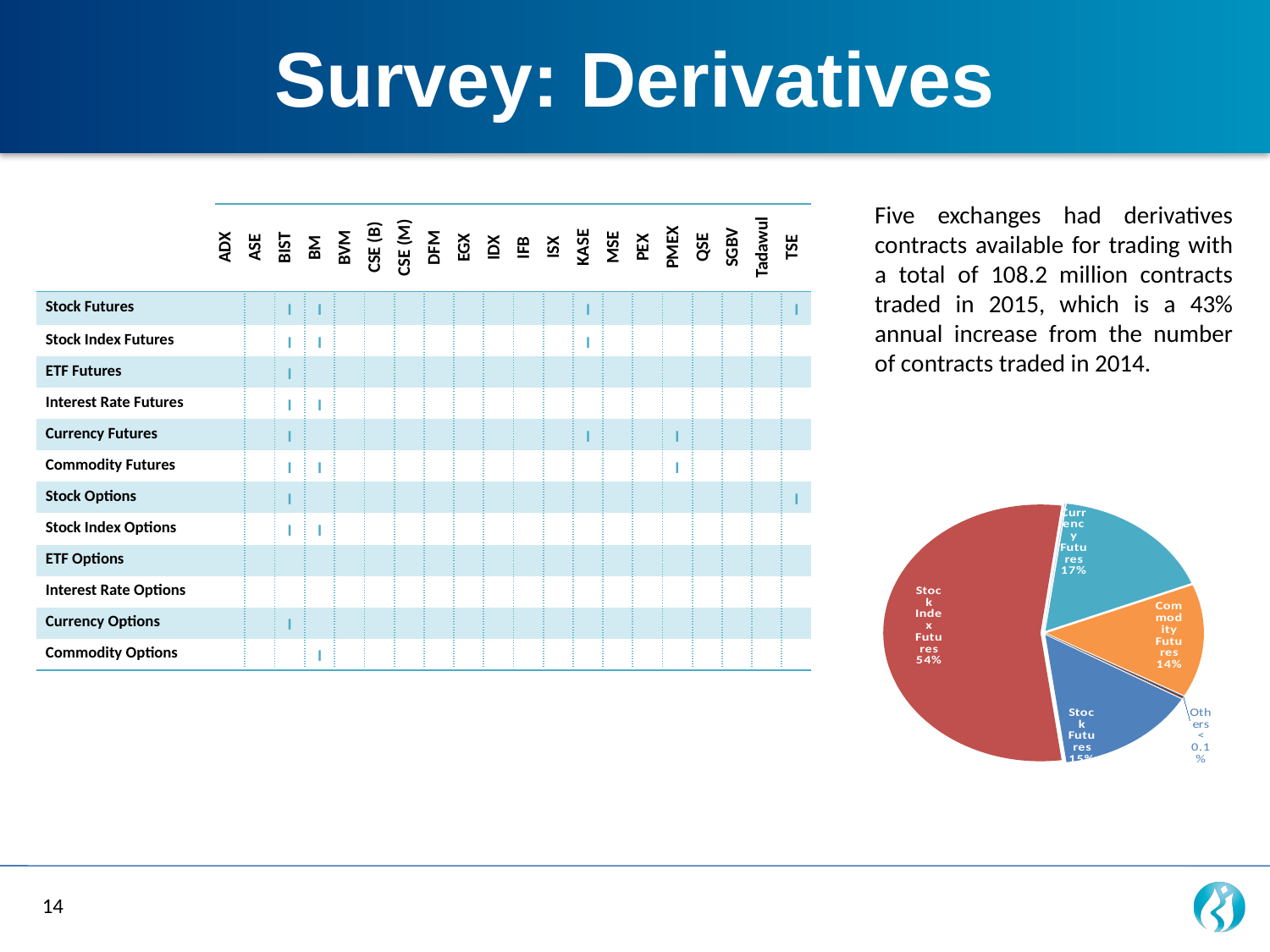
Which slice of the pie chart is the largest? Stock Index Futures What is the difference in percentage points between Stock Index Futures and Currency Futures in the pie chart? 37 What kind of chart is shown on the slide? pie chart Is the share for Stock Index Futures in the pie chart greater or less than 50%? greater In the pie chart, what share do Commodity Futures have? 14% In the pie chart, what share is shown for Others? <0.1% Which slice of the pie chart is the smallest? Others What is the difference in percentage points between Currency Futures and Commodity Futures in the pie chart? 3 In the pie chart, which is larger: Currency Futures or Commodity Futures? Currency Futures In the pie chart, what share do Currency Futures have? 17%